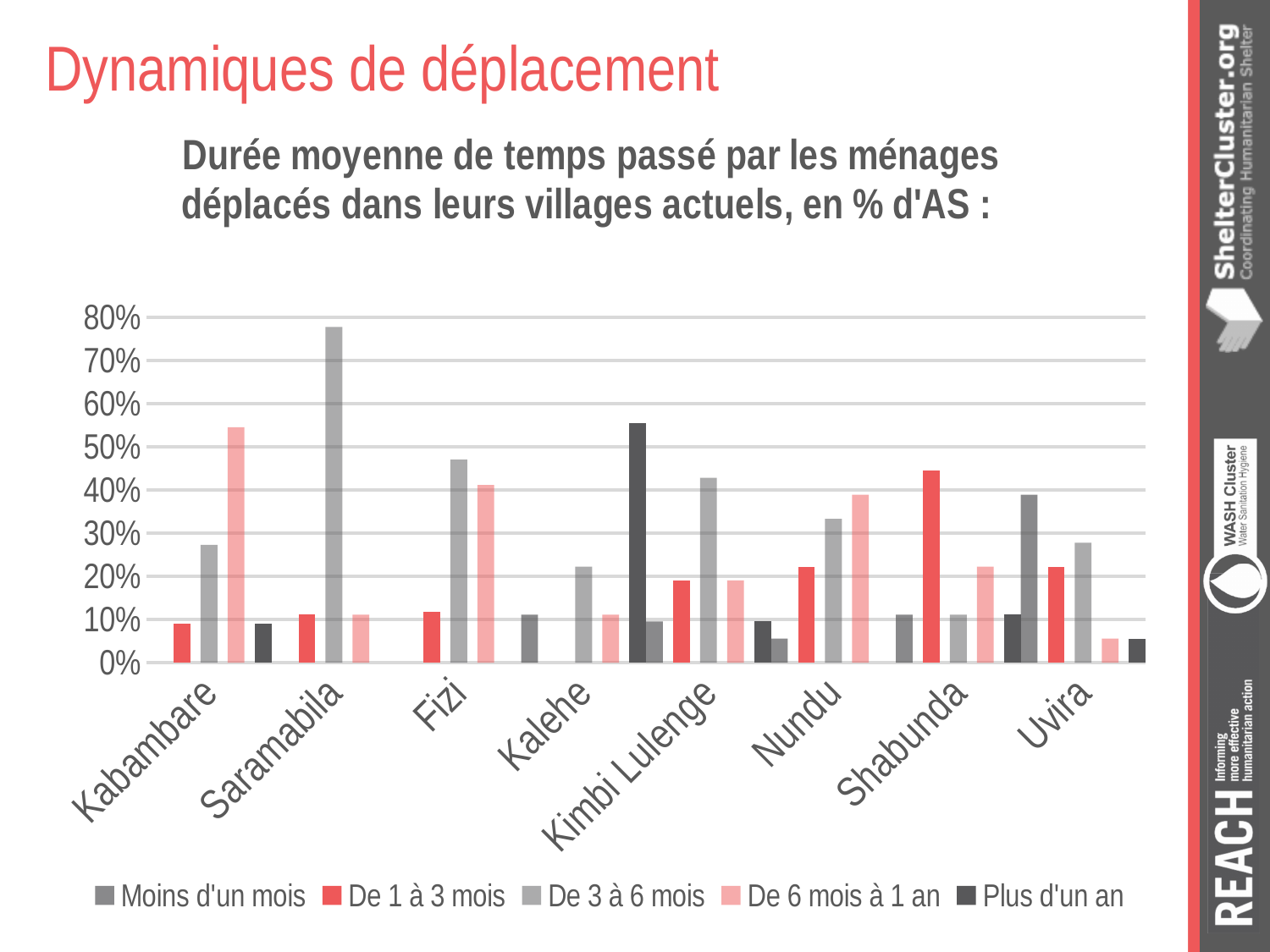
Is the value for 'De 6 mois à 1 an' in Kabambare greater or less than 50%? greater Which is larger in Shabunda: 'De 1 à 3 mois' or 'De 3 à 6 mois'? De 1 à 3 mois Which category has the highest value for the series 'De 3 à 6 mois'? Saramabila Which is larger in Uvira: 'Moins d'un mois' or 'De 6 mois à 1 an'? Moins d'un mois How many categories (villages) are shown on the x axis? 8 What kind of chart is shown on the slide? bar chart How many series does the legend list? 5 Is the value for 'Plus d'un an' in Kalehe greater or less than 50%? greater Which legend entry is shown in red? De 1 à 3 mois Is the value for 'Moins d'un mois' in Nundu greater or less than 10%? less Which category has the highest value for the series 'Moins d'un mois'? Uvira